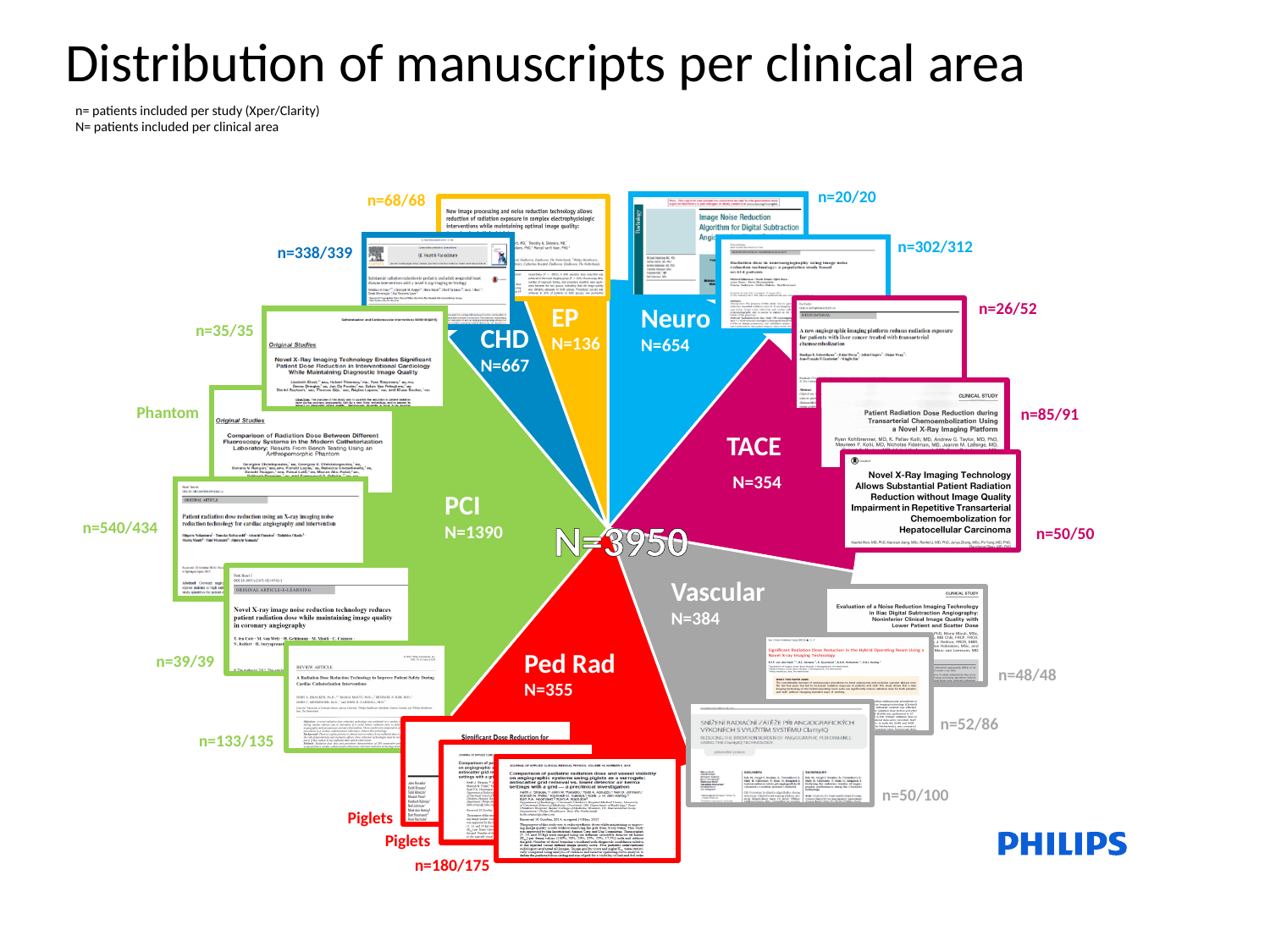
What is the N value for the PCI segment? N=1390 What is the title of the slide? Distribution of manuscripts per clinical area What kind of chart is shown on the slide? pie chart Which clinical area has the largest N value? PCI How many clinical area segments are shown in the pie chart? 7 What is the N value for the EP segment? N=136 What is the N value for the Neuro segment? N=654 What is the N value for the Vascular segment? N=384 What is the difference between the N values for PCI and CHD? 723 Which has a larger N value, TACE or Vascular? Vascular Which clinical area has the smallest N value? EP What total N value is printed at the centre of the pie chart? N=3950